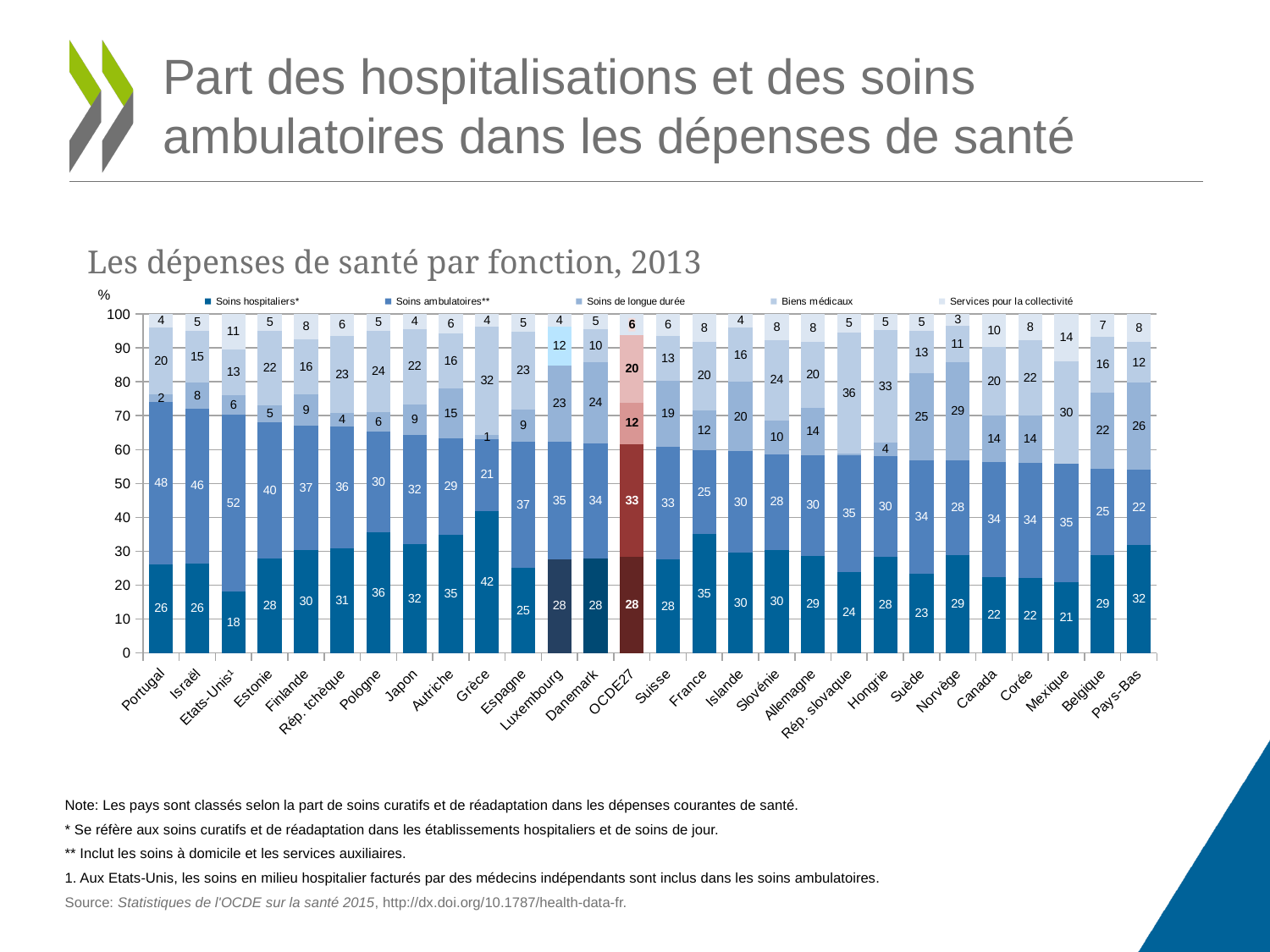
Which country has the lowest value for Soins hospitaliers? Etats-Unis Which country has the highest value for Soins hospitaliers? Grèce What is the value of Soins hospitaliers for Grèce? 42 How many bars (countries/groups) are plotted along the x axis? 28 What is the value of Soins ambulatoires for Etats-Unis? 52 Which is larger, the Soins ambulatoires value for Portugal or for Israël? Portugal Which country has the highest value for Biens médicaux? Rép. slovaque How many series does the legend list? 5 What is the title of the chart? Les dépenses de santé par fonction, 2013 What is the difference between the Soins hospitaliers values for Grèce and Etats-Unis? 24 What is the value of Soins de longue durée for OCDE27? 12 What kind of chart is shown on the slide? Stacked bar chart